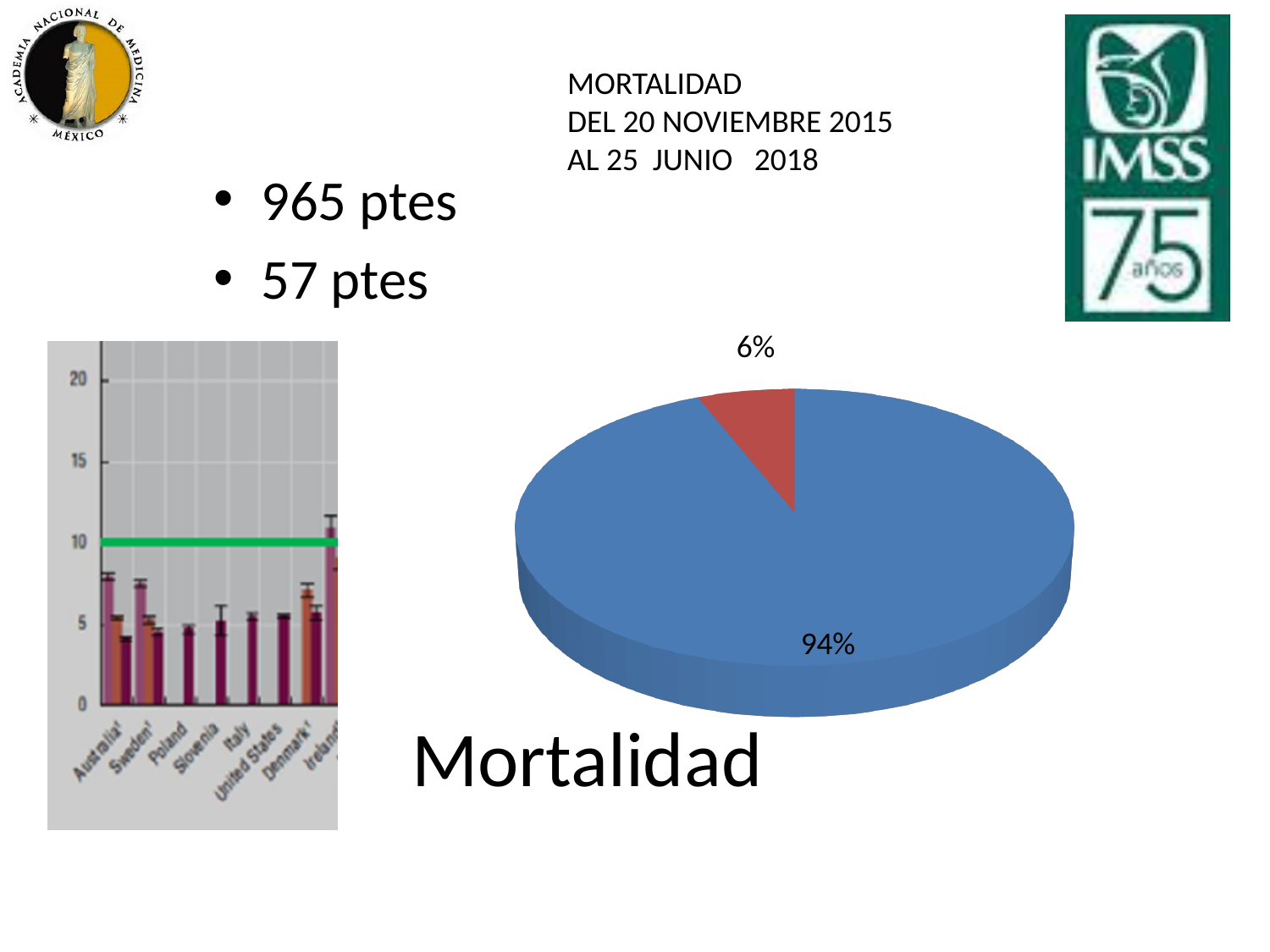
In the pie chart on the right, what colour is the 6% slice? red In the pie chart on the right, what is the share of the smaller (red) slice? 6% In the pie chart on the right, what is the share of the larger (blue) slice? 94% In the bar chart on the left, is the value for Poland greater or less than 10? less What title is printed below the pie chart on the right? Mortalidad What kind of chart is the chart on the right of the slide, labelled "Mortalidad"? pie chart In the bar chart on the left, is the value for Slovenia greater or less than 15? less In the pie chart on the right, how many slices are there? 2 In the pie chart on the right, what is the difference in percentage points between the two slices? 88 What kind of chart is the chart on the left of the slide, with country names on the x axis? bar chart In the pie chart on the right, which slice is larger, the blue one or the red one? the blue one In the bar chart on the left, is the tallest bar for Ireland greater or less than 10? greater